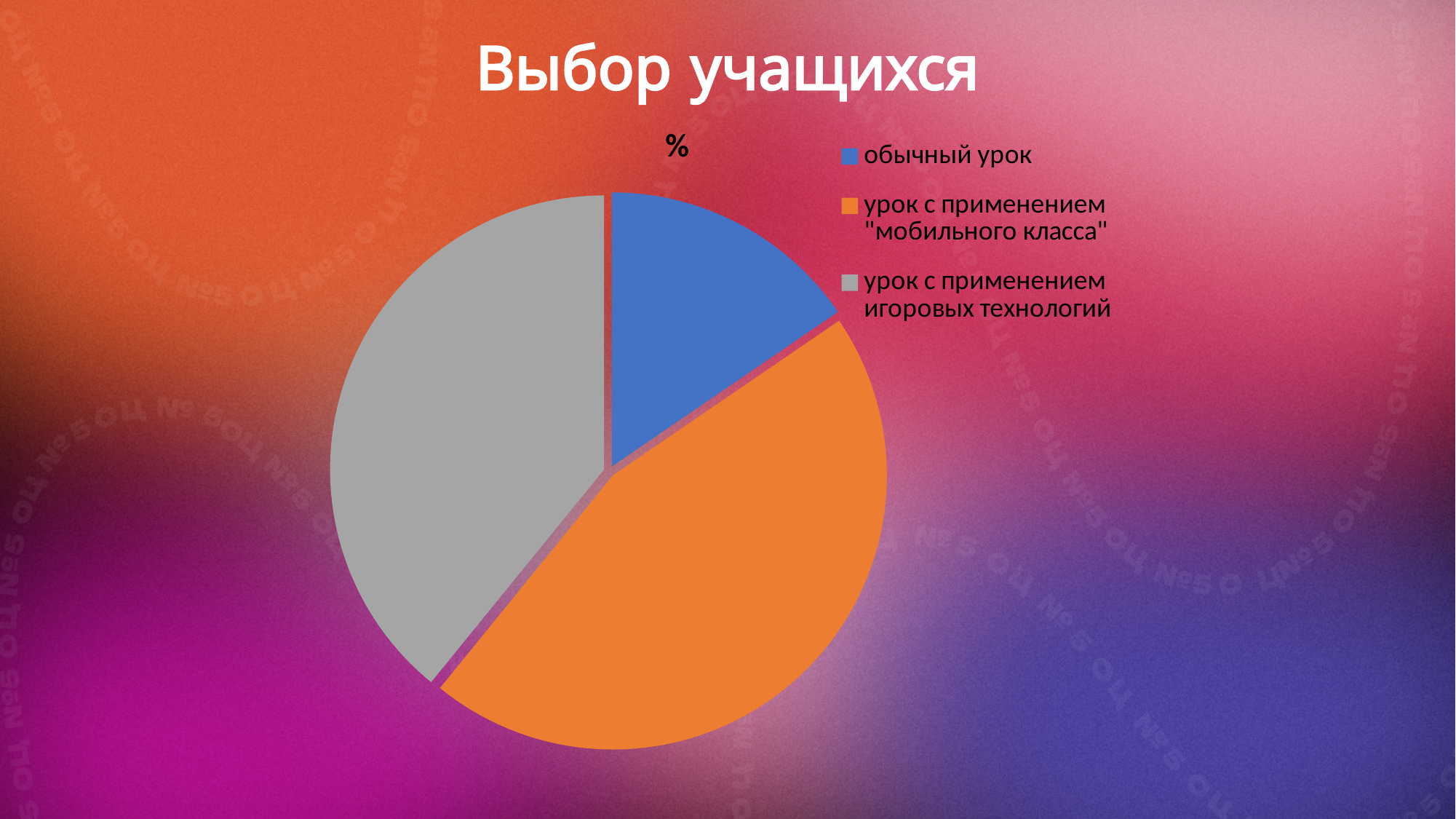
What colour is the slice for обычный урок in the pie chart? blue Which slice is larger: обычный урок or урок с применением "мобильного класса"? урок с применением "мобильного класса" What kind of chart is shown on the slide? pie chart How many slices does the pie chart have? 3 Which slice is larger: обычный урок or урок с применением игоровых технологий? урок с применением игоровых технологий Which category has the largest slice in the pie chart? урок с применением "мобильного класса" How many entries does the legend of the pie chart list? 3 What is the title of the slide containing the pie chart? Выбор учащихся Which category has the smallest slice in the pie chart? обычный урок